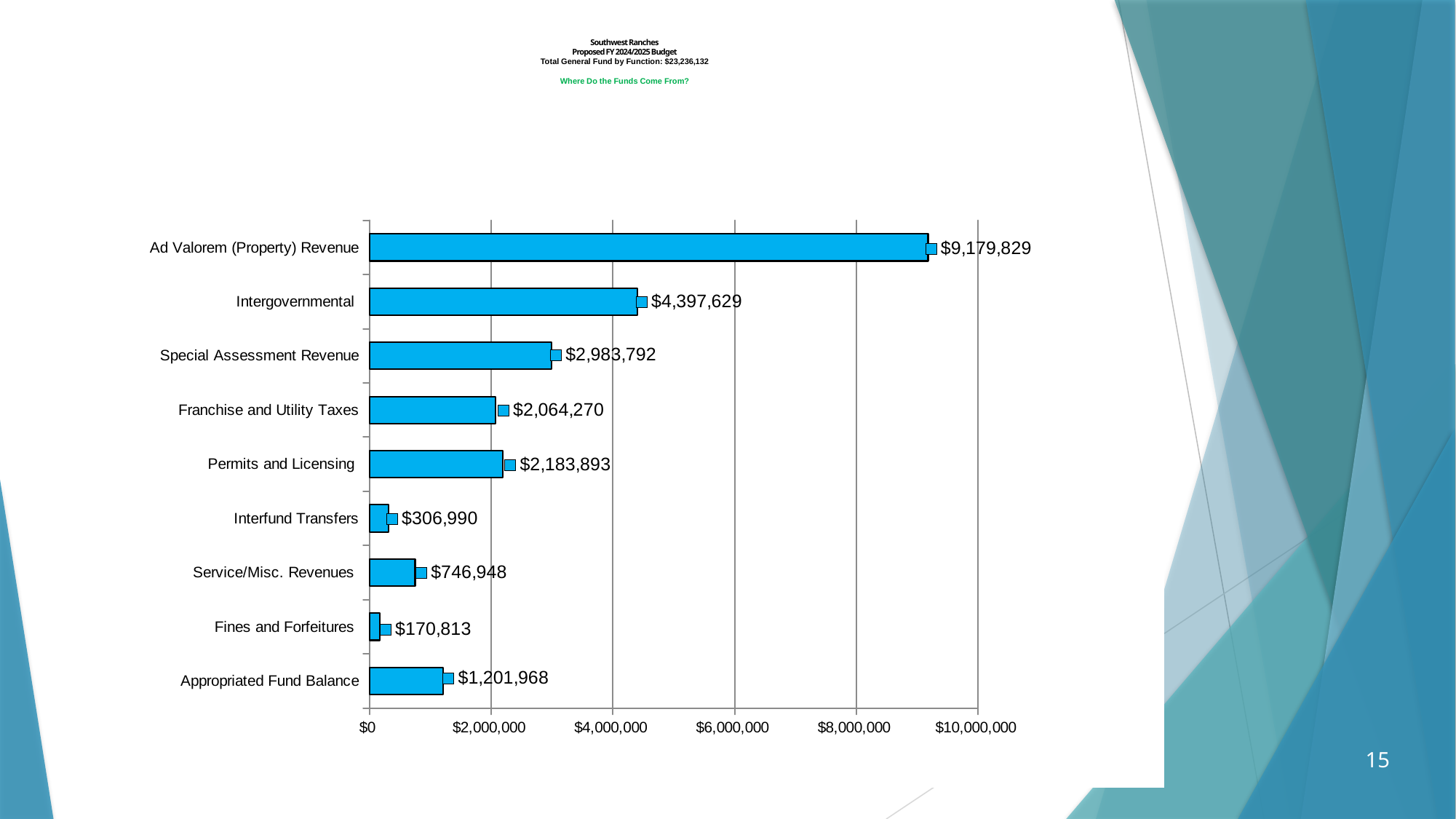
Is the value for Intergovernmental greater or less than $4,000,000? greater What is the value for Appropriated Fund Balance? $1,201,968 What is the value for Ad Valorem (Property) Revenue? $9,179,829 What is the difference between Ad Valorem (Property) Revenue and Intergovernmental? $4,782,200 What kind of chart is shown on the slide? bar chart What is the value for Intergovernmental? $4,397,629 Which category has the highest value? Ad Valorem (Property) Revenue Which category has the lowest value? Fines and Forfeitures How many categories are shown in the chart? 9 Which is larger, Permits and Licensing or Franchise and Utility Taxes? Permits and Licensing What total General Fund amount is stated in the chart title? $23,236,132 What is the difference between Service/Misc. Revenues and Interfund Transfers? $439,958